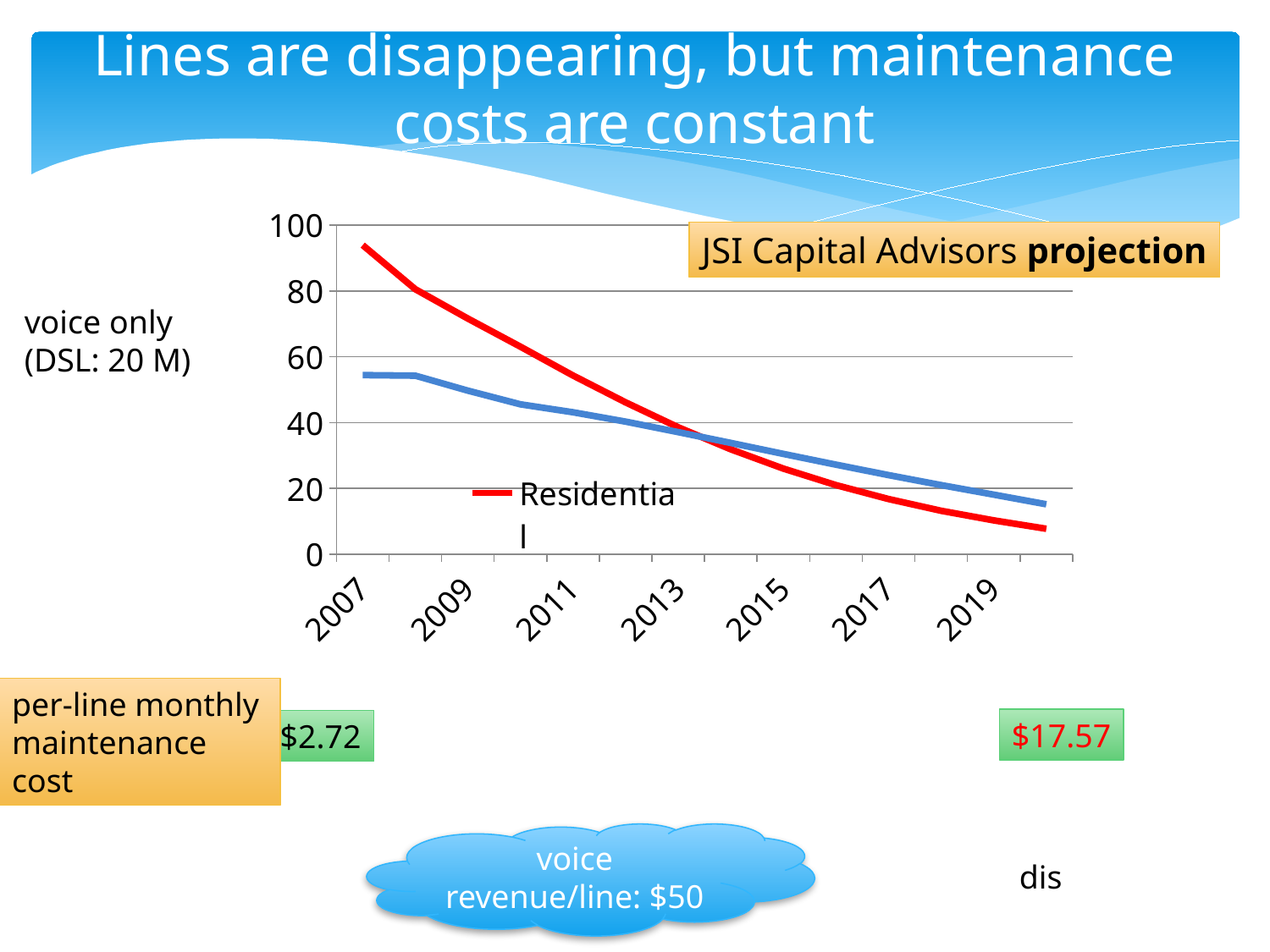
Is the Residential value for 2017 greater or less than 40? less How many year labels are shown on the x axis? 7 Does the Residential line rise or fall from 2007 to 2019? fall Which is larger, the Residential value for 2007 or for 2019? 2007 What kind of chart is shown on the slide? line chart Which year has the highest Residential value? 2007 What is the highest value shown on the y axis? 100 Is the Residential value for 2015 greater or less than 40? less Is the Residential value for 2007 greater or less than 80? greater Which series is named in the chart legend? Residential How many lines are plotted on the chart? 2